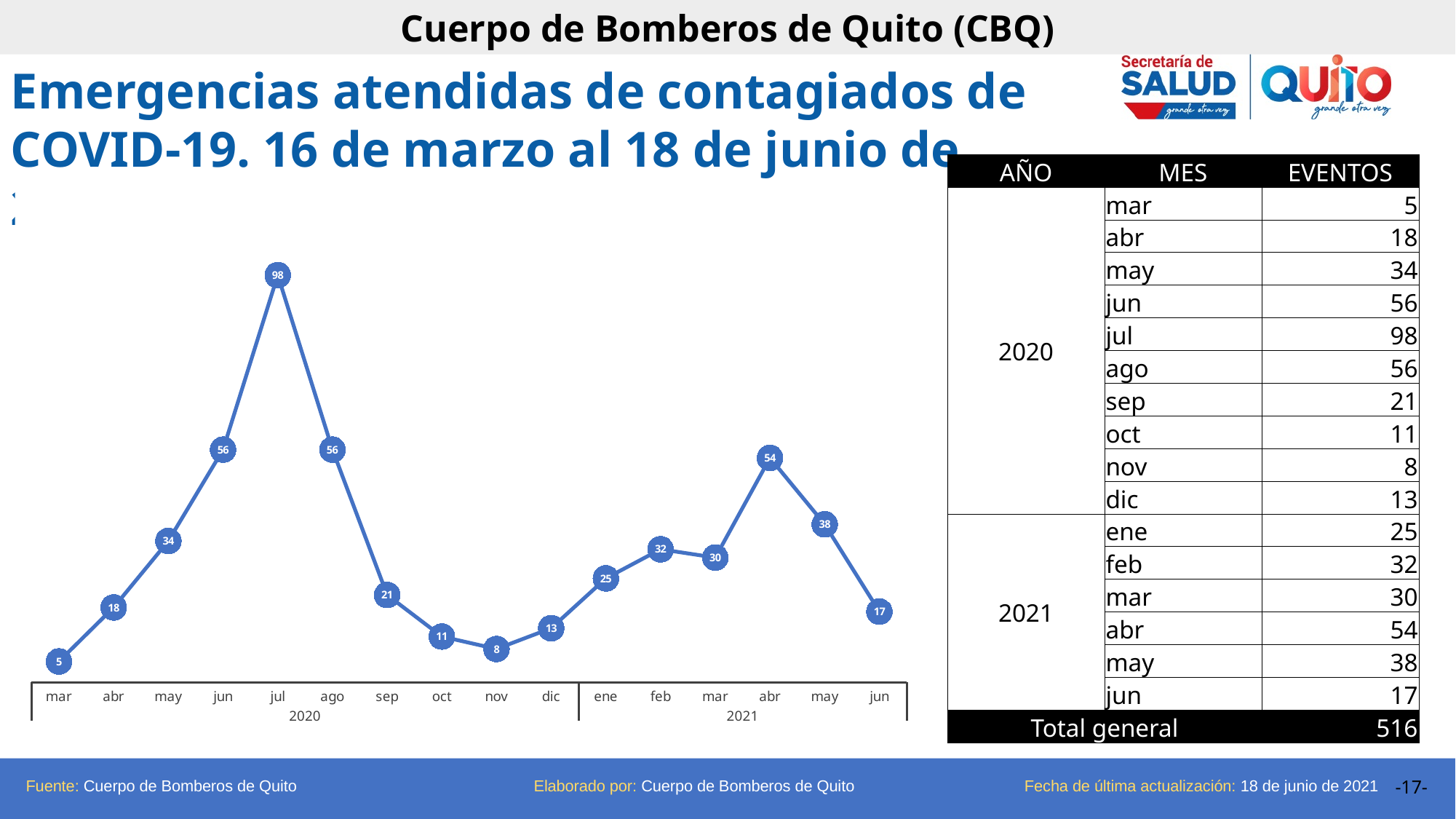
What is the value for abr 2021? 54 What is the value for nov 2020? 8 What type of chart is shown on the slide? line chart Do the values rise or fall from abr 2021 to jun 2021? fall Which is larger, the value for may 2021 or the value for feb 2021? may 2021 How many data points are plotted on the chart? 16 What is the difference between the values for abr 2021 and jun 2021? 37 What is the difference between the values for jul 2020 and ago 2020? 42 Do the values rise or fall from mar 2020 to jul 2020? rise What is the value for jul 2020? 98 Which month has the highest value? jul 2020 Which month has the lowest value? mar 2020